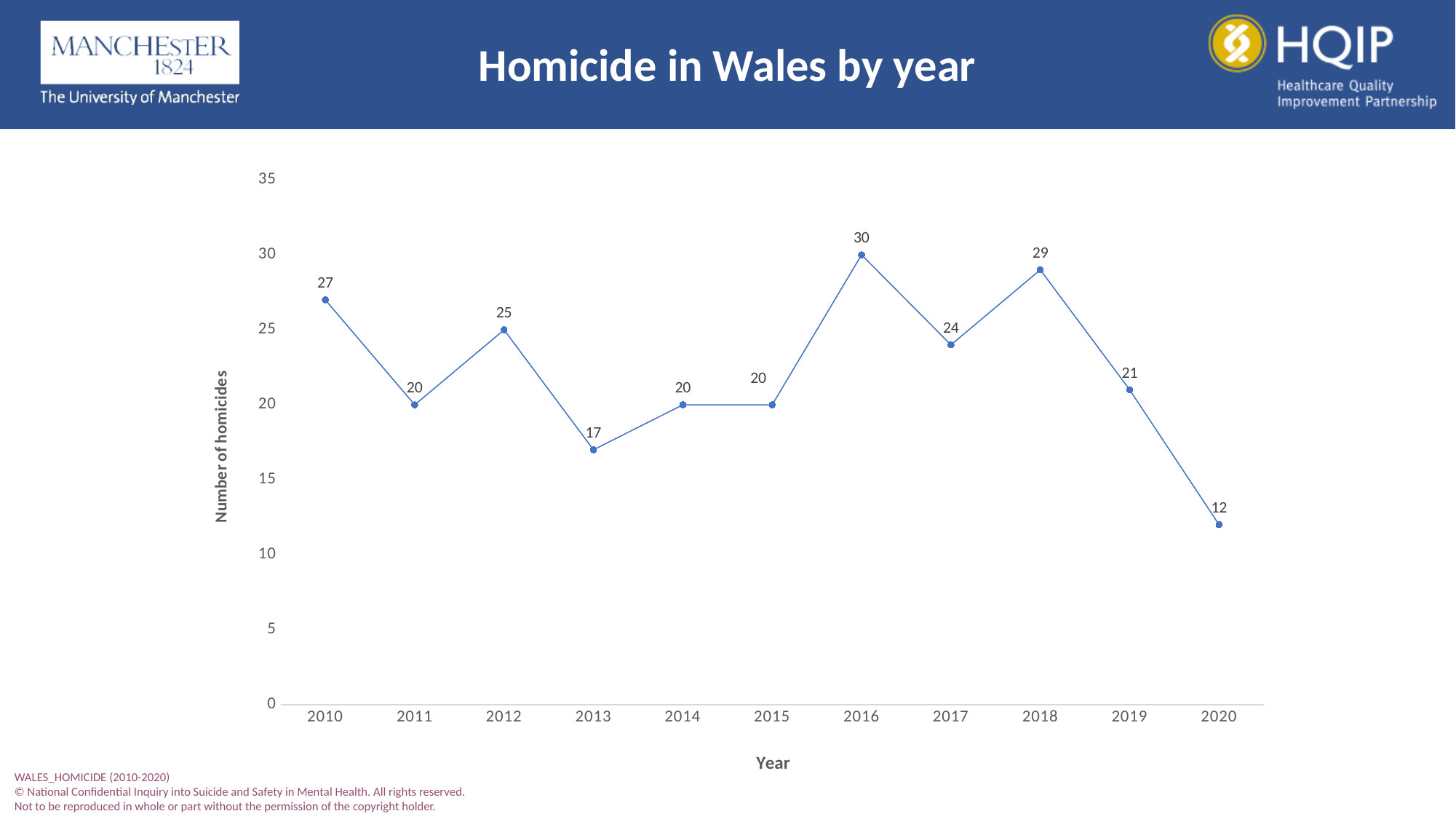
Which year has the lowest number of homicides? 2020 Which year has the highest number of homicides? 2016 What type of chart is shown on the slide? Line chart What is the number of homicides for 2013? 17 What is the difference in the number of homicides between 2018 and 2020? 17 How many homicides were recorded in Wales in 2016? 30 Did the number of homicides rise or fall from 2018 to 2020? Fall What is the difference in the number of homicides between 2010 and 2011? 7 Which year had more homicides, 2012 or 2017? 2012 What is the title of the chart? Homicide in Wales by year What is the label on the y axis? Number of homicides How many years are plotted on the x axis? 11